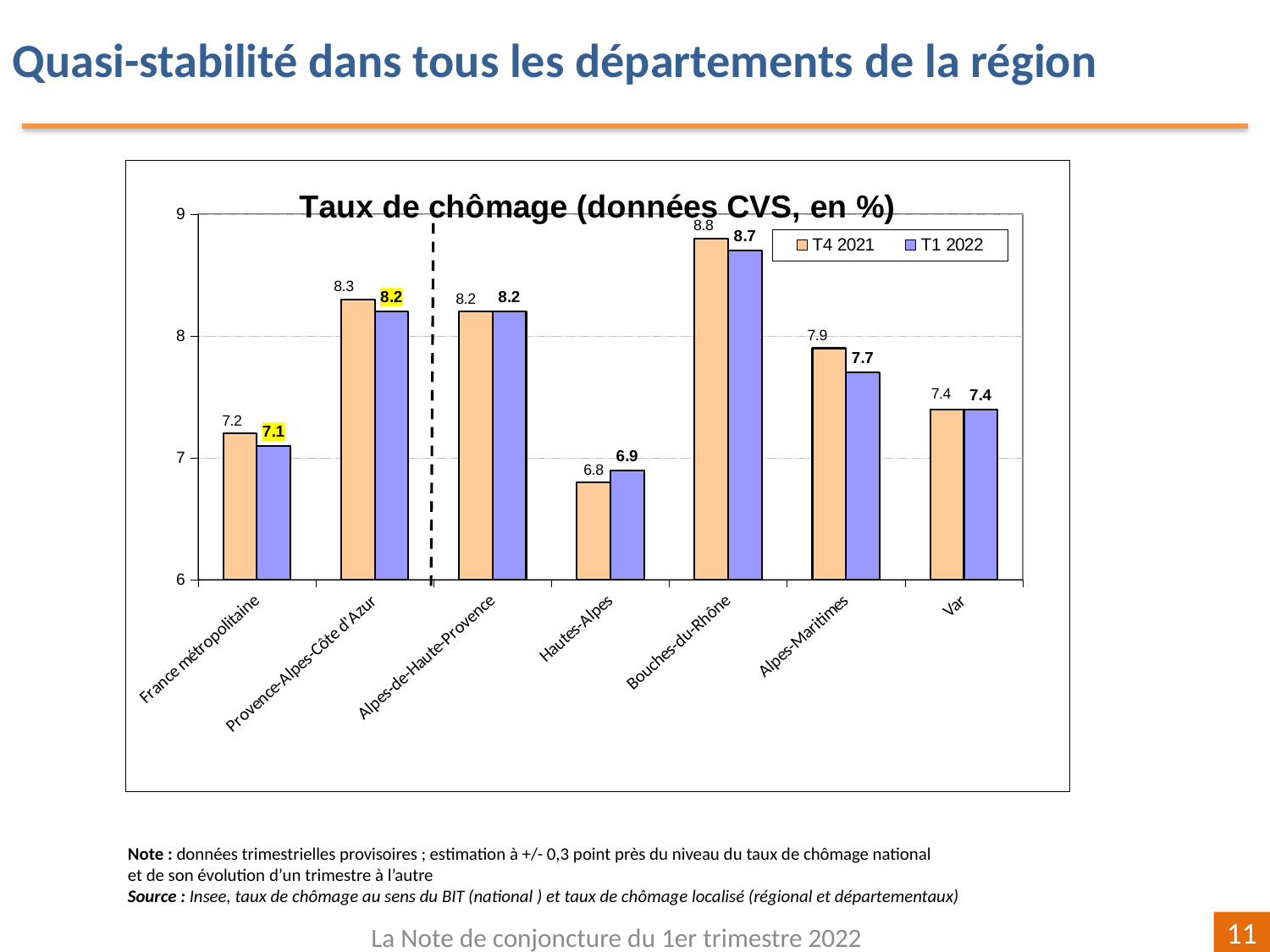
What is the T1 2022 value for Provence-Alpes-Côte d'Azur? 8.2 Is the T1 2022 value for France métropolitaine greater or less than 8? less What kind of chart is shown on the slide? Bar chart What is the T4 2021 value for Hautes-Alpes? 6.8 What is the T1 2022 unemployment rate for Bouches-du-Rhône? 8.7 Which is larger for Var: the T4 2021 value or the T1 2022 value? They are equal (7.4) How many series does the legend list? 2 What is the difference between the T4 2021 and T1 2022 values for Alpes-Maritimes? 0.2 Which category has the highest T4 2021 value? Bouches-du-Rhône Which category has the lowest T1 2022 value? Hautes-Alpes How many categories are shown on the x axis? 7 What is the title of the chart? Taux de chômage (données CVS, en %)